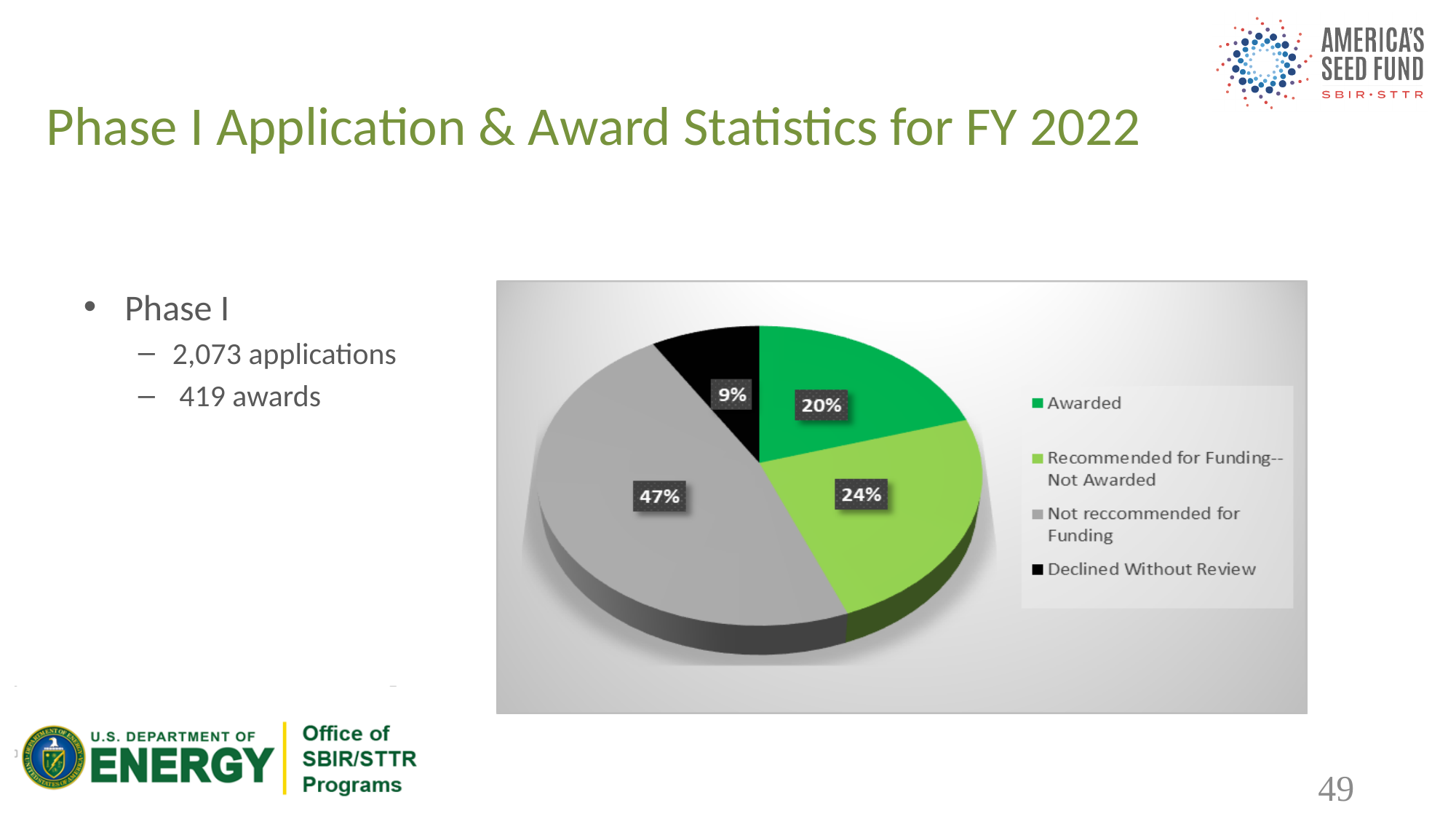
What colour is the Not recommended for Funding slice? Grey Which category has the smallest slice of the pie? Declined Without Review What share of the pie is labelled Not recommended for Funding? 47% What share of the pie is labelled Recommended for Funding--Not Awarded? 24% What kind of chart is shown on the slide? Pie chart What share of the pie is labelled Declined Without Review? 9% What is the difference in percentage points between the Not recommended for Funding slice and the Awarded slice? 27 Which is larger, the Awarded slice or the Recommended for Funding--Not Awarded slice? Recommended for Funding--Not Awarded How many categories does the pie chart have? 4 What colour is the Declined Without Review slice? Black Which category has the largest slice of the pie? Not recommended for Funding